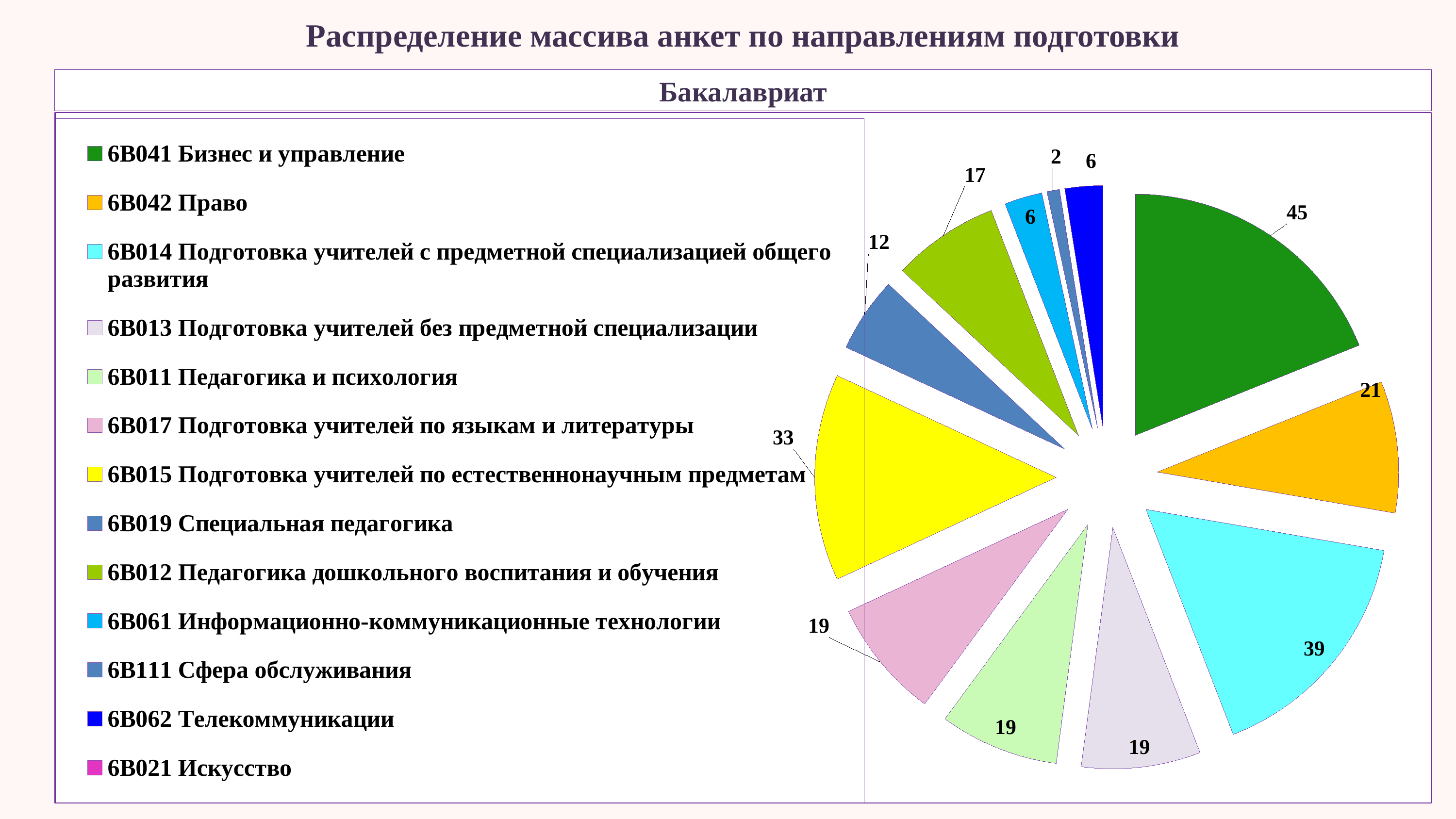
What is the value for 6B014 Подготовка учителей с предметной специализацией общего развития? 39 How many entries does the legend list? 13 What is the value for 6B015 Подготовка учителей по естественнонаучным предметам? 33 Which category has the largest slice? 6B041 Бизнес и управление What is the value for 6B019 Специальная педагогика? 12 Which category has the smallest labelled slice? 6B111 Сфера обслуживания What is the value for 6B111 Сфера обслуживания? 2 What kind of chart is shown on the slide? pie chart What is the value for 6B041 Бизнес и управление? 45 What is the value for 6B042 Право? 21 What is the difference between the values for 6B041 Бизнес и управление and 6B014 Подготовка учителей с предметной специализацией общего развития? 6 Which is larger, the value for 6B015 Подготовка учителей по естественнонаучным предметам or 6B042 Право? 6B015 Подготовка учителей по естественнонаучным предметам